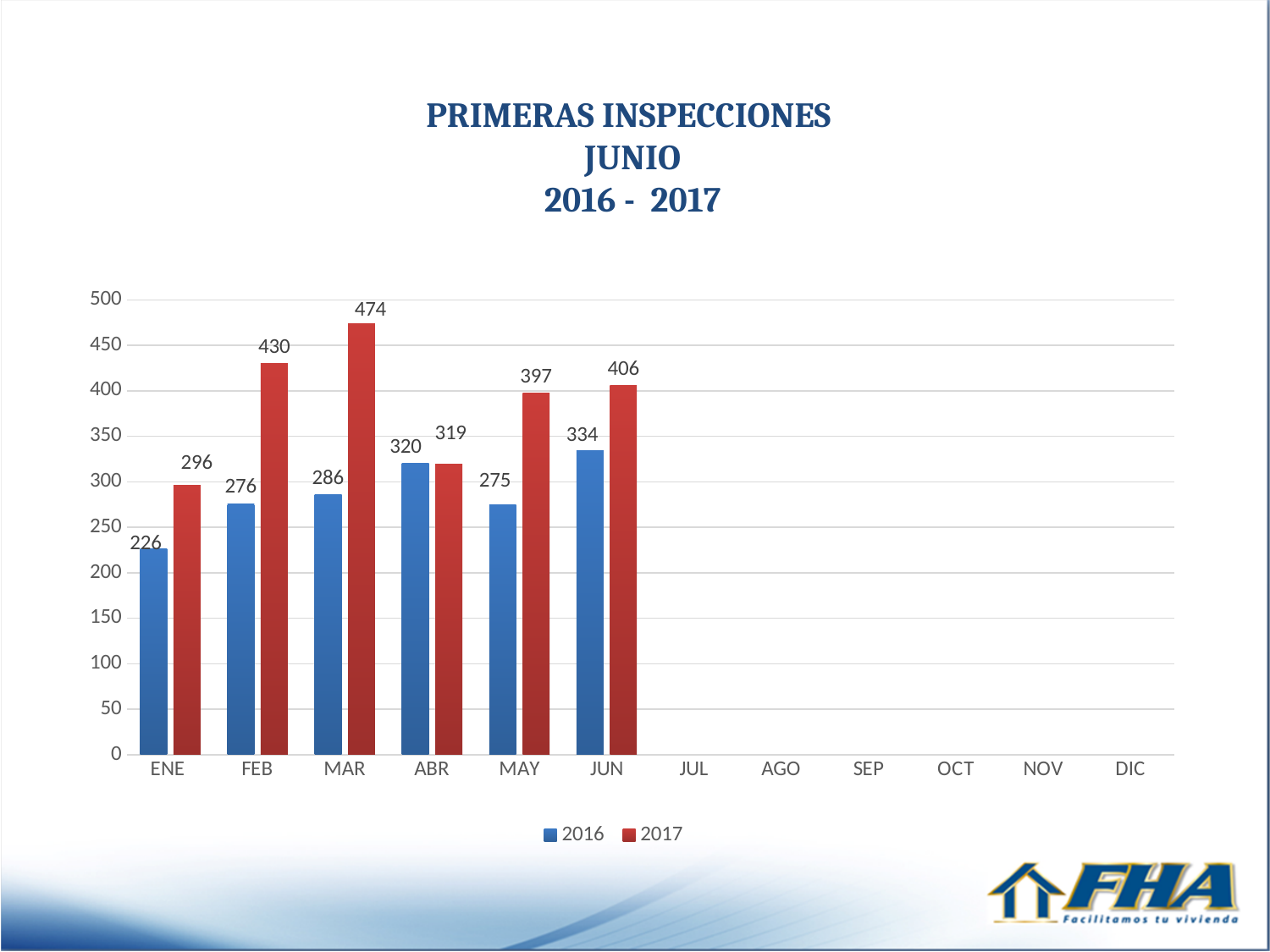
What is the value for 2016 in ENE? 226 What kind of chart is shown on the slide? bar chart How many series does the legend list? 2 What is the value for 2016 in JUN? 334 How many months have data plotted for both series? 6 Is the value for 2017 in MAY greater or less than 350? greater Which is larger in ABR, the 2016 value or the 2017 value? 2016 Which month has the lowest value for the 2016 series? ENE What is the value for 2017 in MAR? 474 What is the difference between the 2017 and 2016 values in FEB? 154 Which month has the highest value for the 2017 series? MAR What colour represents the 2017 series? red